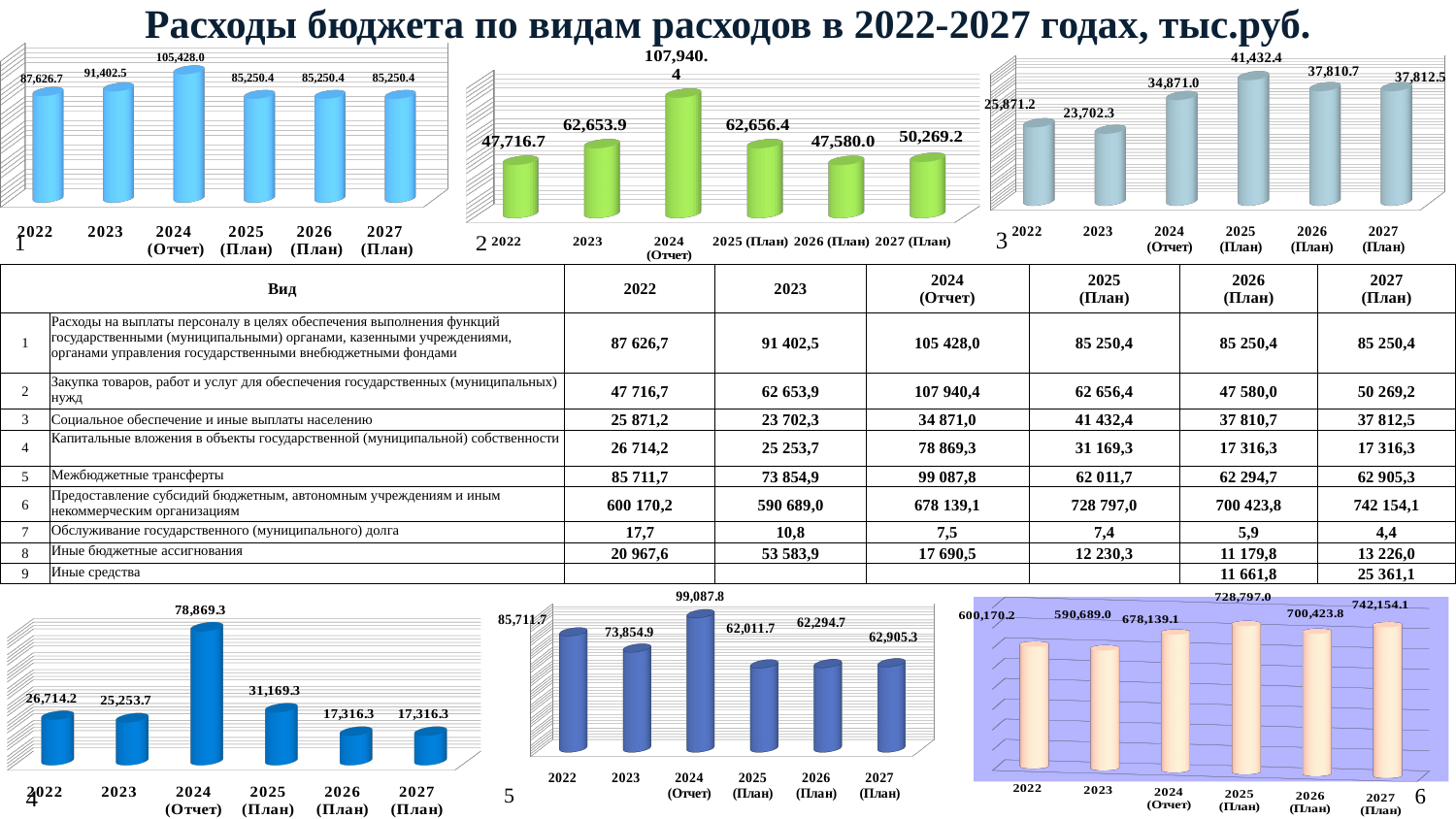
In chart 3 (top right), what is the value for 2025 (План)? 41,432.4 In chart 4 (bottom left), what is the difference between the 2024 (Отчет) value and the 2025 (План) value? 47,700.0 In chart 6 (bottom right), which year has the lowest value? 2023 What type of chart is chart 2 (top middle)? bar chart In chart 2 (top middle), which year has the highest value? 2024 (Отчет) In chart 3 (top right), which year has the lowest value? 2023 What is the title of the slide containing the charts? Расходы бюджета по видам расходов в 2022-2027 годах, тыс.руб. In chart 6 (bottom right), what is the value for 2027 (План)? 742,154.1 How many bars does chart 1 (top left) have? 6 In chart 4 (bottom left), what is the value for 2026 (План)? 17,316.3 In chart 1 (top left), what is the value for 2024 (Отчет)? 105,428.0 In chart 5 (bottom middle), which is larger: the value for 2022 or the value for 2023? 2022